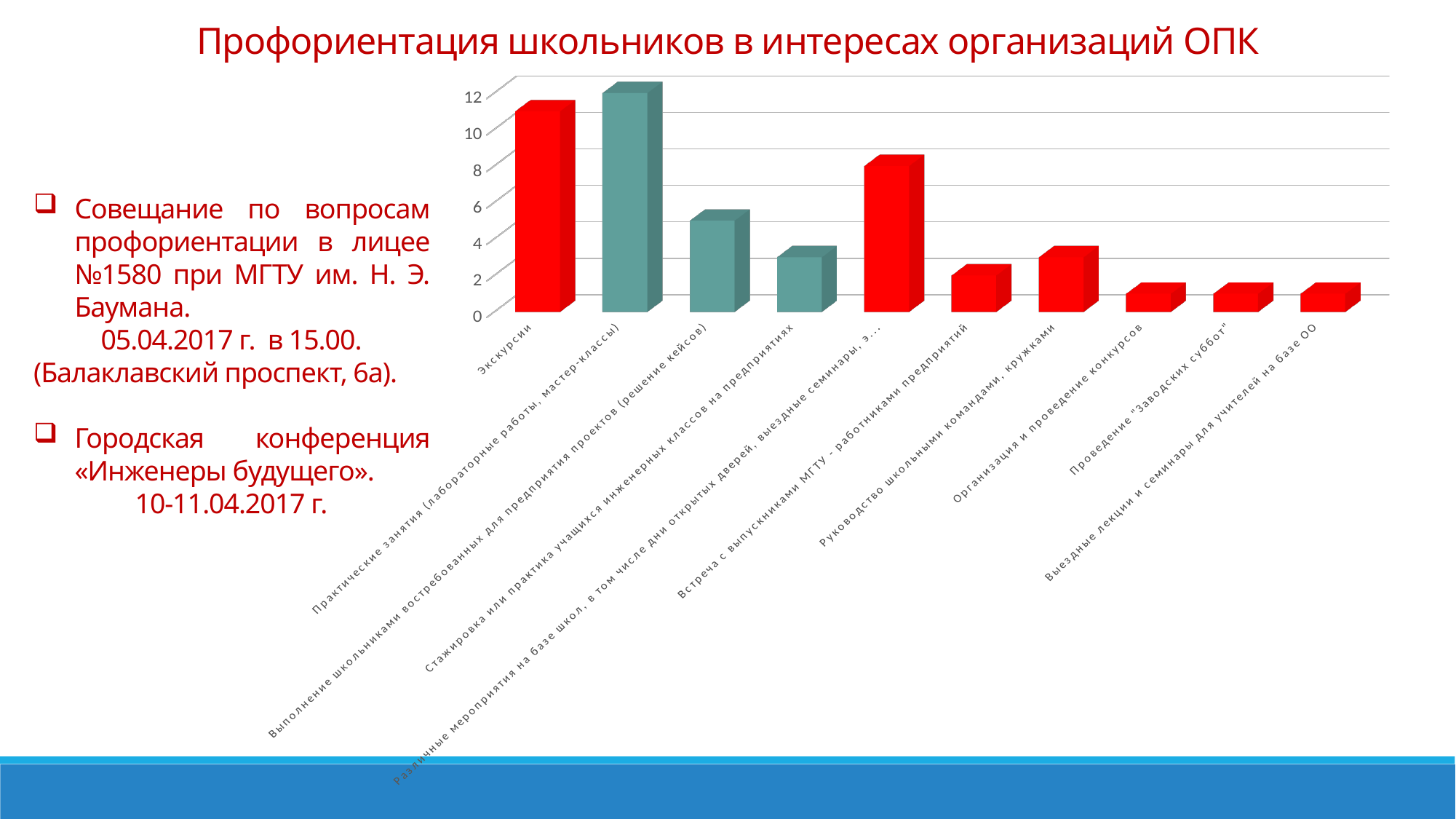
Which is larger: the value for Руководство школьными командами, кружками or the value for Практические занятия (лабораторные работы, мастер-классы)? Практические занятия (лабораторные работы, мастер-классы) What is the title of the slide containing the chart? Профориентация школьников в интересах организаций ОПК Is the value for Стажировка или практика учащихся инженерных классов на предприятиях greater or less than 4? less Is the value for Организация и проведение конкурсов greater or less than 2? less What colour are the bars for Практические занятия, Выполнение проектов and Стажировка, compared with the other bars? teal (the others are red) Is the value for Выполнение школьниками востребованных для предприятия проектов (решение кейсов) greater or less than 6? less How many categories are plotted in the chart? 10 Which category has the highest bar in the chart? Практические занятия (лабораторные работы, мастер-классы) What kind of chart is shown on the slide? bar chart Which is larger: the value for Экскурсии or the value for Выполнение школьниками востребованных для предприятия проектов (решение кейсов)? Экскурсии